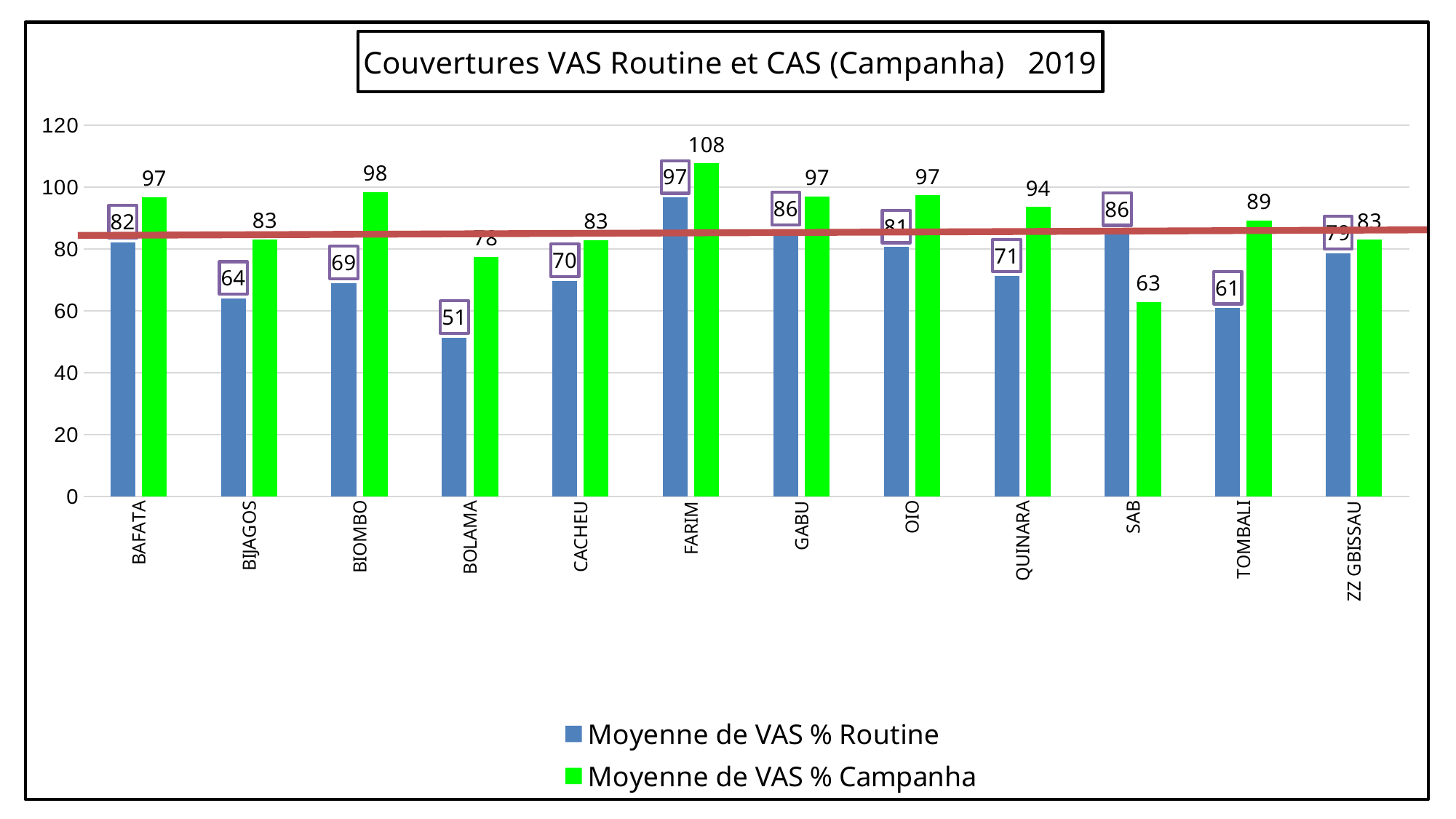
Which region has the lowest Moyenne de VAS % Campanha value? SAB What is the Moyenne de VAS % Routine value for BOLAMA? 51 How many regions (categories) are shown on the x axis? 12 What is the title of the chart? Couvertures VAS Routine et CAS (Campanha) 2019 How many series does the legend list? 2 What is the Moyenne de VAS % Campanha value for TOMBALI? 89 Which region has the lowest Moyenne de VAS % Routine value? BOLAMA Which region has the highest Moyenne de VAS % Campanha value? FARIM What is the Moyenne de VAS % Campanha value for FARIM? 108 What is the difference between the Campanha and Routine values for FARIM? 11 For SAB, which is larger: the Routine value or the Campanha value? Routine What kind of chart is shown on the slide? bar chart